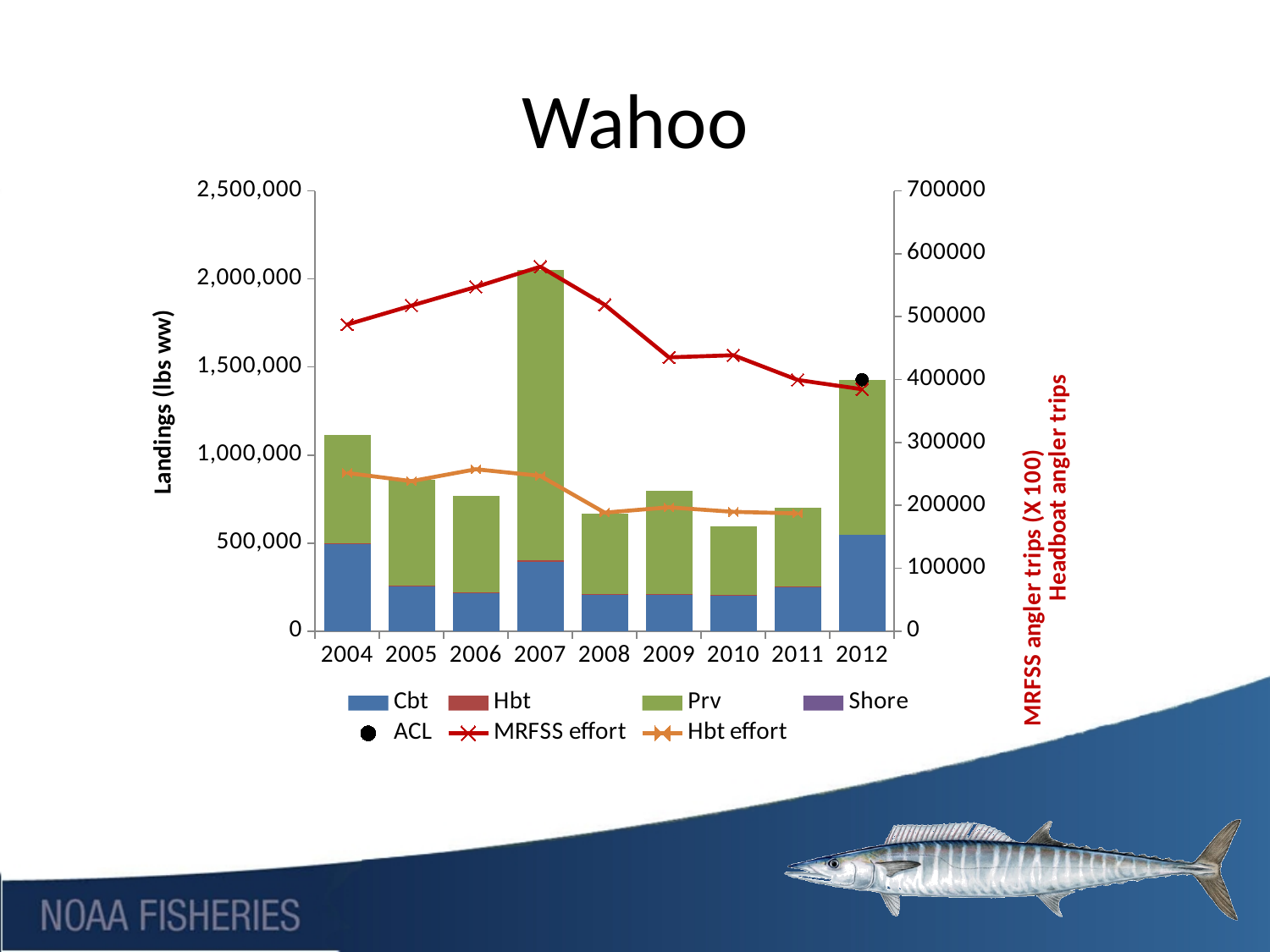
Is the Hbt effort value for 2004 greater or less than 200000? greater How many entries does the chart legend list? 7 How many years are shown on the x axis of the chart? 9 Is the MRFSS effort value for 2007 greater or less than 500000? greater Is the total landings bar for 2007 greater or less than 1,500,000? greater What kind of chart is shown on the slide? Stacked bar chart combined with line series What is the title of the chart? Wahoo In which year is the total landings bar the highest? 2007 In which year does the MRFSS effort line reach its highest value? 2007 Which year has the larger total landings bar, 2004 or 2005? 2004 Does the MRFSS effort line rise or fall from 2007 to 2012? fall